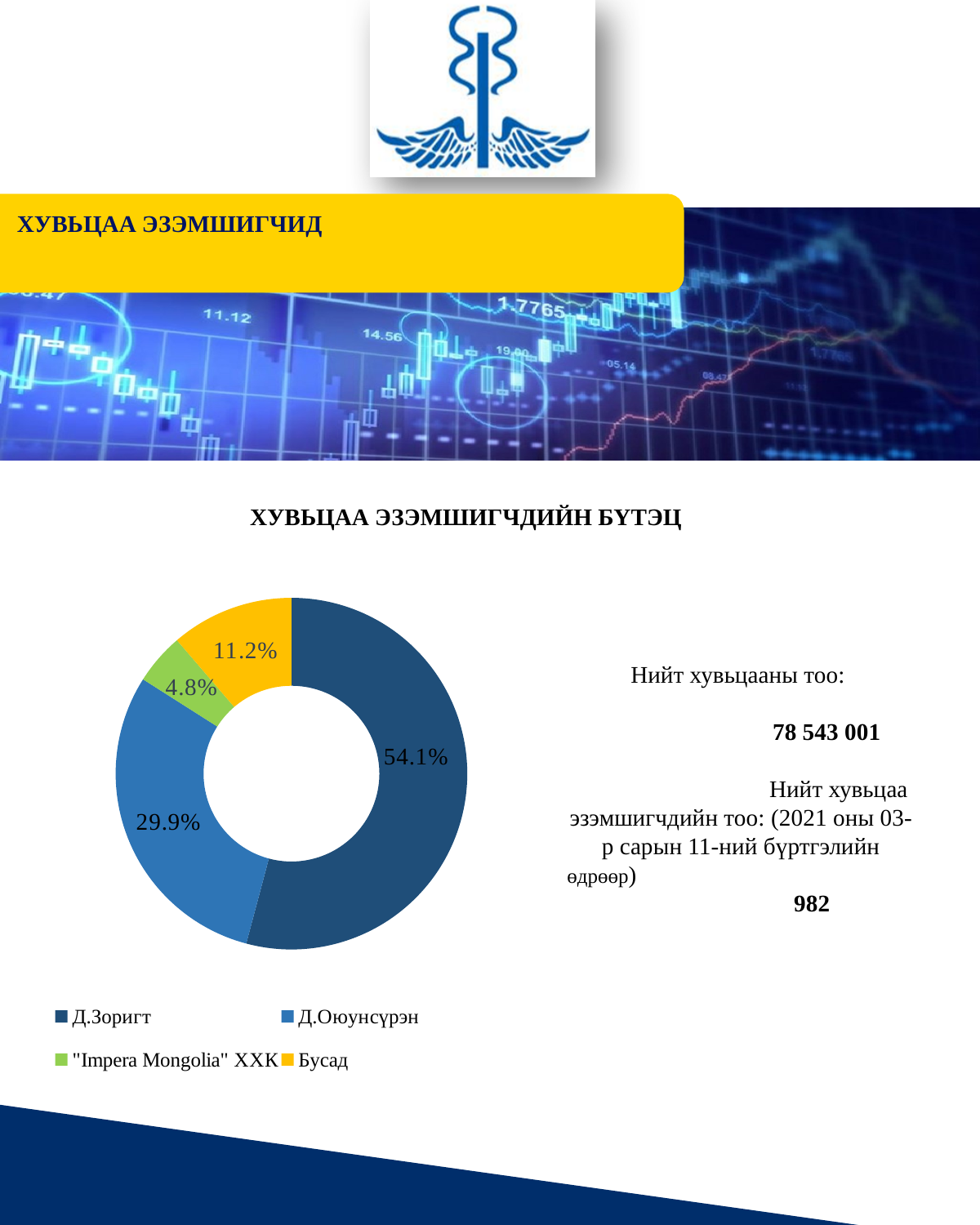
What type of chart is shown on the slide? Doughnut chart How many slices does the doughnut chart have? 4 Which slice is larger: Бусад or "Impera Mongolia" ХХК? Бусад Which shareholder has the smallest slice in the chart? "Impera Mongolia" ХХК Which legend entry is shown in yellow? Бусад Which shareholder has the largest slice in the chart? Д.Зоригт What is the title of the chart? ХУВЬЦАА ЭЗЭМШИГЧДИЙН БҮТЭЦ What share of the doughnut chart does "Impera Mongolia" ХХК hold? 4.8% What share of the doughnut chart does Д.Оюунсүрэн hold? 29.9% What is the difference in percentage points between the shares of Д.Зоригт and Д.Оюунсүрэн? 24.2 What share of the doughnut chart does Д.Зоригт hold? 54.1% What share of the doughnut chart does Бусад hold? 11.2%